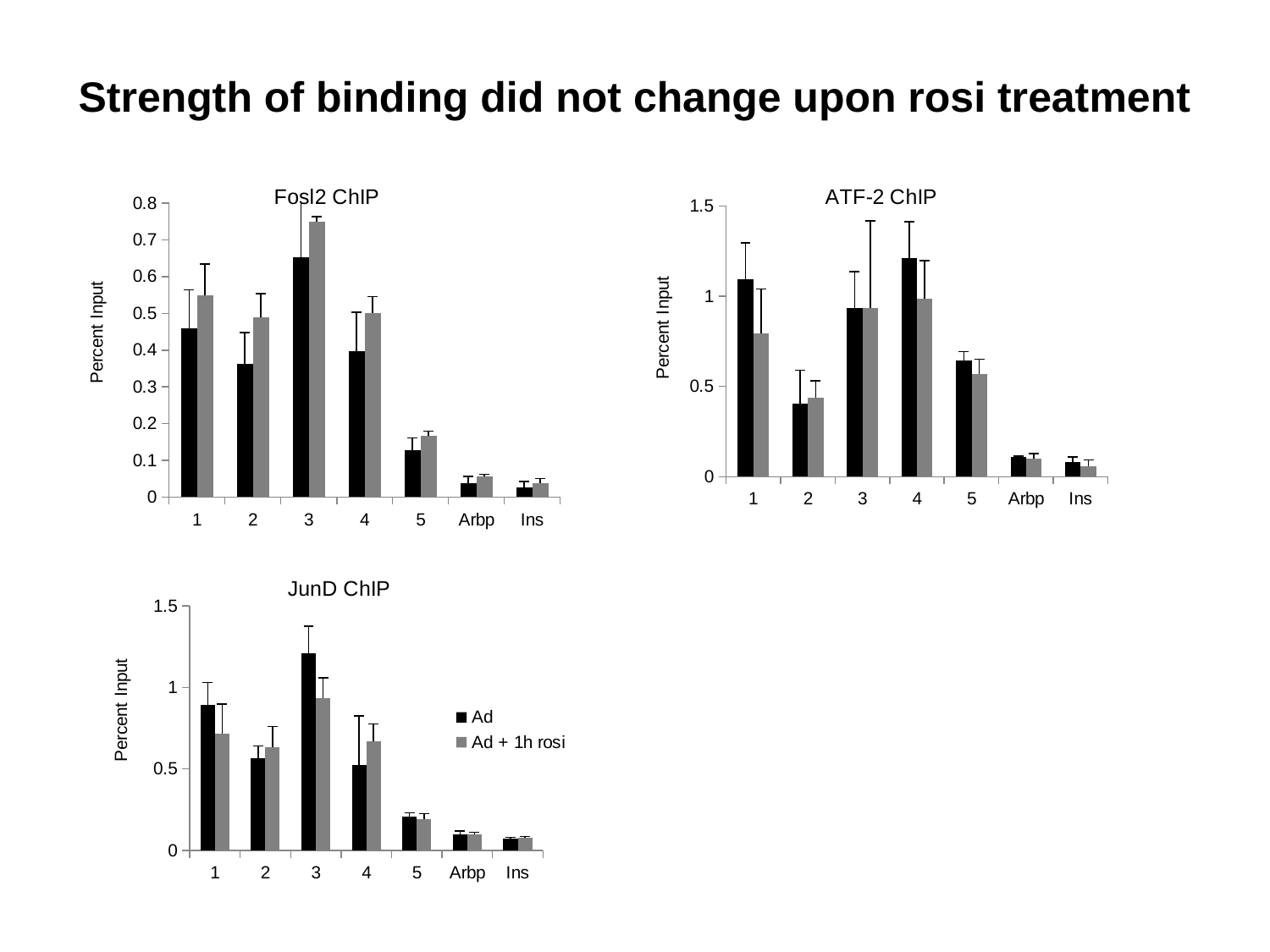
In the ATF-2 ChIP chart, for category 1, which bar is taller, Ad or Ad + 1h rosi? Ad How many categories are shown on the x axis of the JunD ChIP chart? 7 In the ATF-2 ChIP chart, is the Ad value for category 2 greater or less than 0.5? less What kind of chart is the Fosl2 ChIP chart? bar chart What are the two series named in the legend on the JunD ChIP chart? Ad and Ad + 1h rosi In the JunD ChIP chart, is the Ad value for category 3 greater or less than 1? greater In the JunD ChIP chart, for category 3, which series has the larger value, Ad or Ad + 1h rosi? Ad How many series does the legend on the JunD ChIP chart list? 2 What is the y-axis label on the ATF-2 ChIP chart? Percent Input In the Fosl2 ChIP chart, which category has the highest Ad value? 3 In the JunD ChIP chart, which category has the highest Ad value? 3 In the Fosl2 ChIP chart, is the Ad value for category 3 greater or less than 0.6? greater